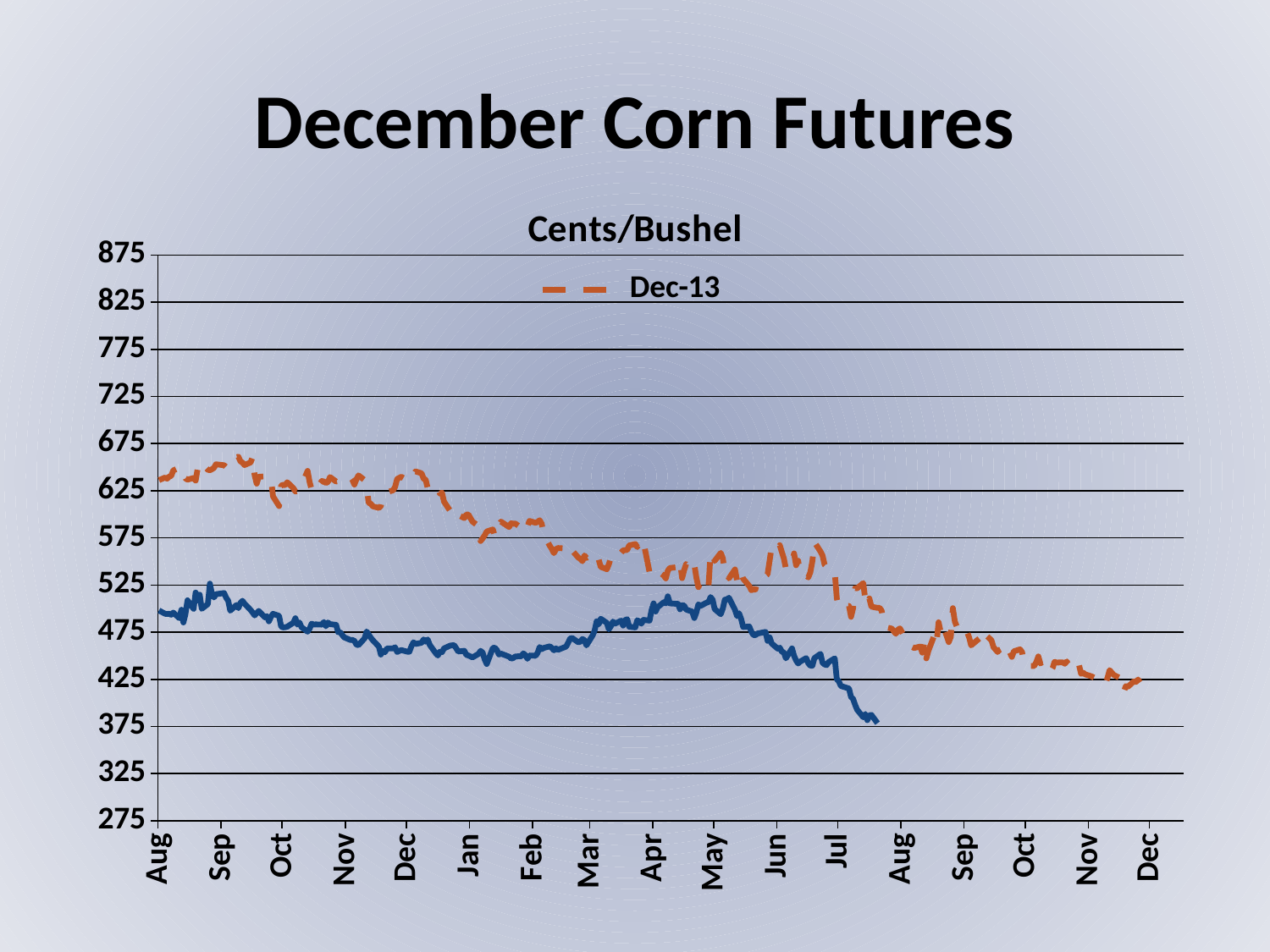
Is the Dec-13 value at Nov (second Nov on the axis) greater or less than 475? less Is the value of the solid blue line at its end near Jul greater or less than 425? less How many month labels are shown along the x axis? 17 Is the Dec-13 value at the first Aug greater or less than 600? greater At the first Aug on the x axis, which is higher: the Dec-13 dashed line or the solid blue line? Dec-13 Does the solid blue line overall rise or fall from the first Aug to its end near Jul? fall What is the title printed above the chart's plot area? Cents/Bushel What is the name of the series shown in the legend? Dec-13 How many series does the chart legend list? 1 Does the Dec-13 series overall rise or fall from the first Aug to Dec on the x axis? fall What kind of chart is shown on the slide? line chart